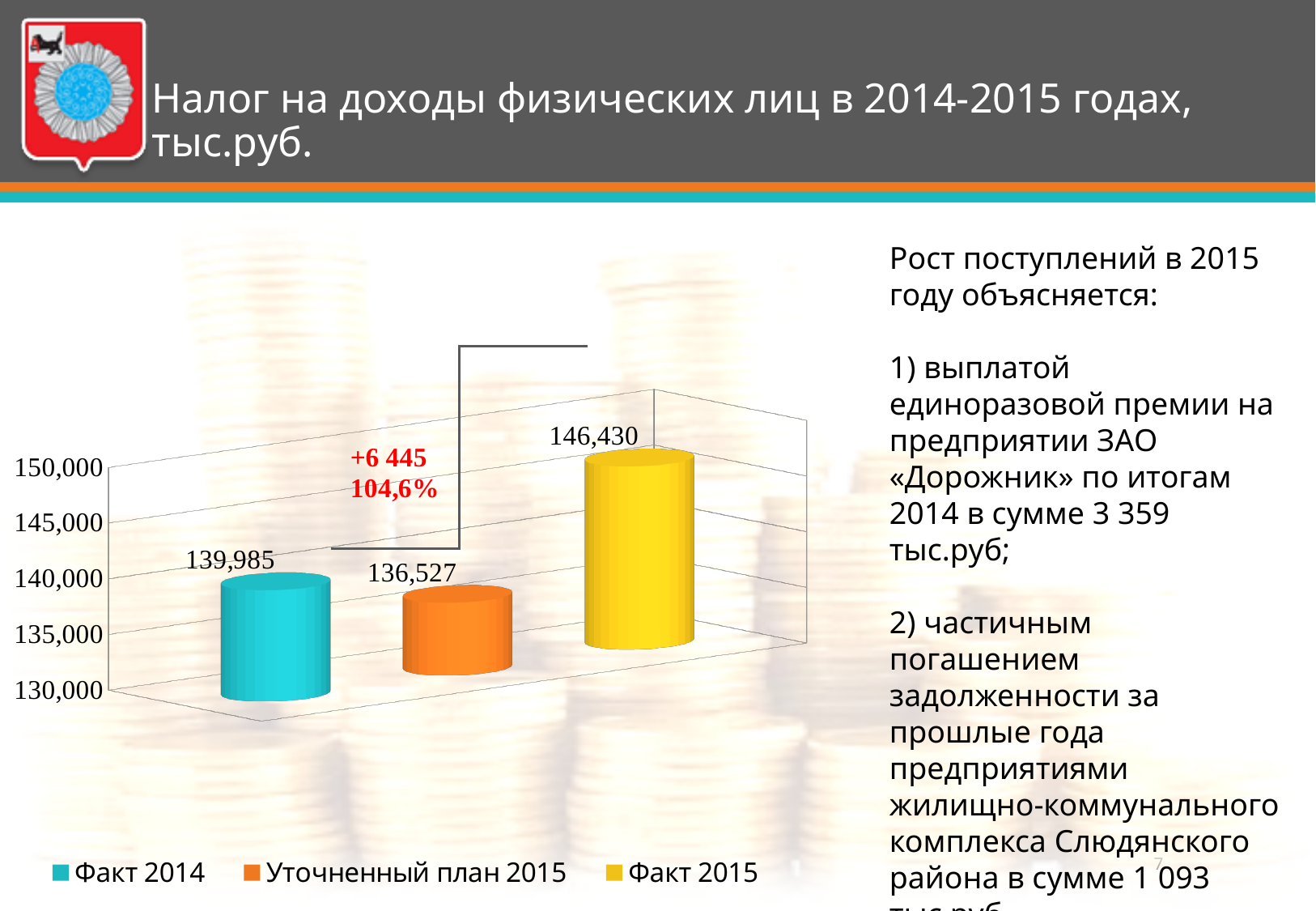
Which series has the lowest value? Уточненный план 2015 Which series has the highest value? Факт 2015 How many series does the legend list? 3 What is the value for Факт 2015? 146,430 Which is larger, Факт 2014 or Уточненный план 2015? Факт 2014 What is the difference between Факт 2015 and Факт 2014? 6,445 What kind of chart is shown on the slide? bar chart What is the value for Уточненный план 2015? 136,527 Is the value for Факт 2015 greater or less than 145,000? greater What is the difference between Факт 2014 and Уточненный план 2015? 3,458 What percentage is shown in the red annotation above the bars? 104,6% What is the value for Факт 2014? 139,985